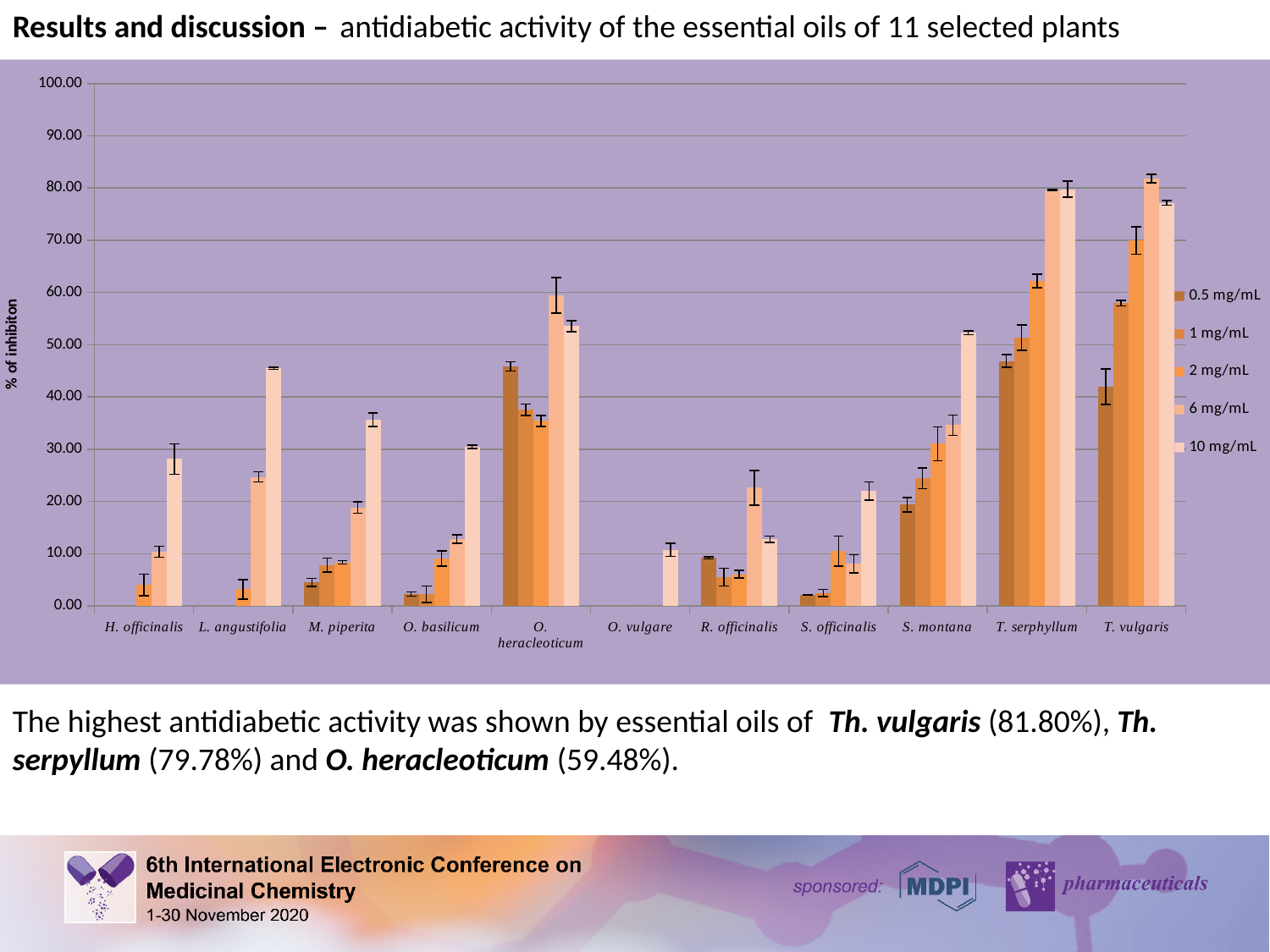
Which is larger: the 0.5 mg/mL value for O. heracleoticum or the 0.5 mg/mL value for S. montana? O. heracleoticum How many series does the chart legend list? 5 Which concentration series is listed first in the chart legend? 0.5 mg/mL What kind of chart is shown on the slide? bar chart Is the 10 mg/mL value for L. angustifolia greater or less than 40? greater How many plant categories are shown along the x axis of the chart? 11 Is the 10 mg/mL value for H. officinalis greater or less than 20? greater For S. montana, do the bars rise or fall as the concentration increases from 0.5 mg/mL to 10 mg/mL? rise Is the 0.5 mg/mL value for O. heracleoticum greater or less than 40? greater Which plant category contains the tallest bar in the chart? T. vulgaris What is the label of the y axis of the chart? % of inhibiton